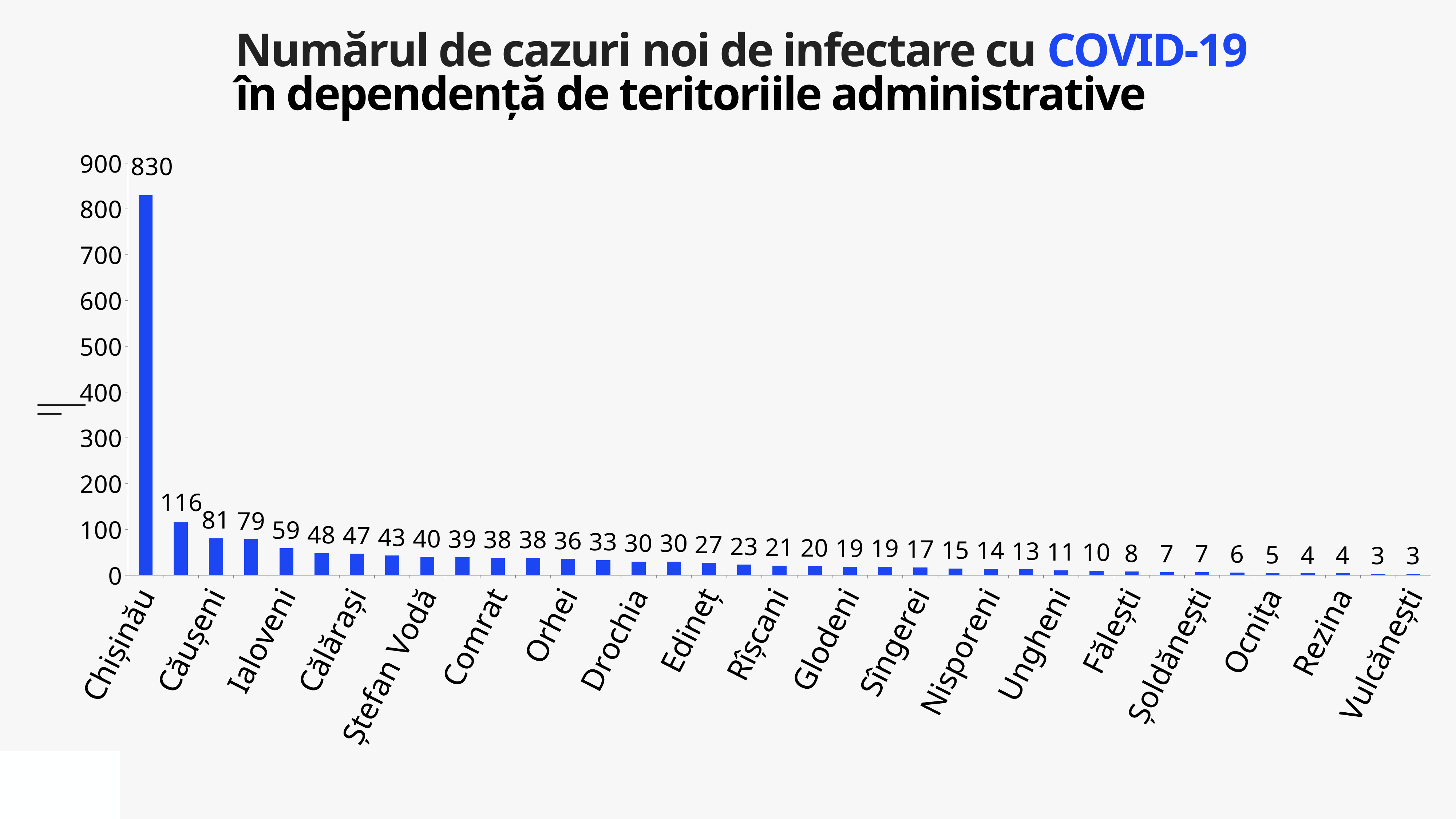
Do the values rise or fall from left to right along the x axis? fall Which has a larger value, Ialoveni or Comrat? Ialoveni Which territory has the highest number of new cases? Chișinău What is the value shown for Căușeni? 81 What is the highest value shown on the vertical axis? 900 What is the difference between the values for Chișinău and Căușeni? 749 Is the value for Chișinău greater or less than 800? greater What kind of chart is shown on the slide? bar chart What is the number of new COVID-19 cases for Chișinău? 830 What is the value shown for Ialoveni? 59 What is the value shown for Orhei? 36 What is the value shown for Ungheni? 11